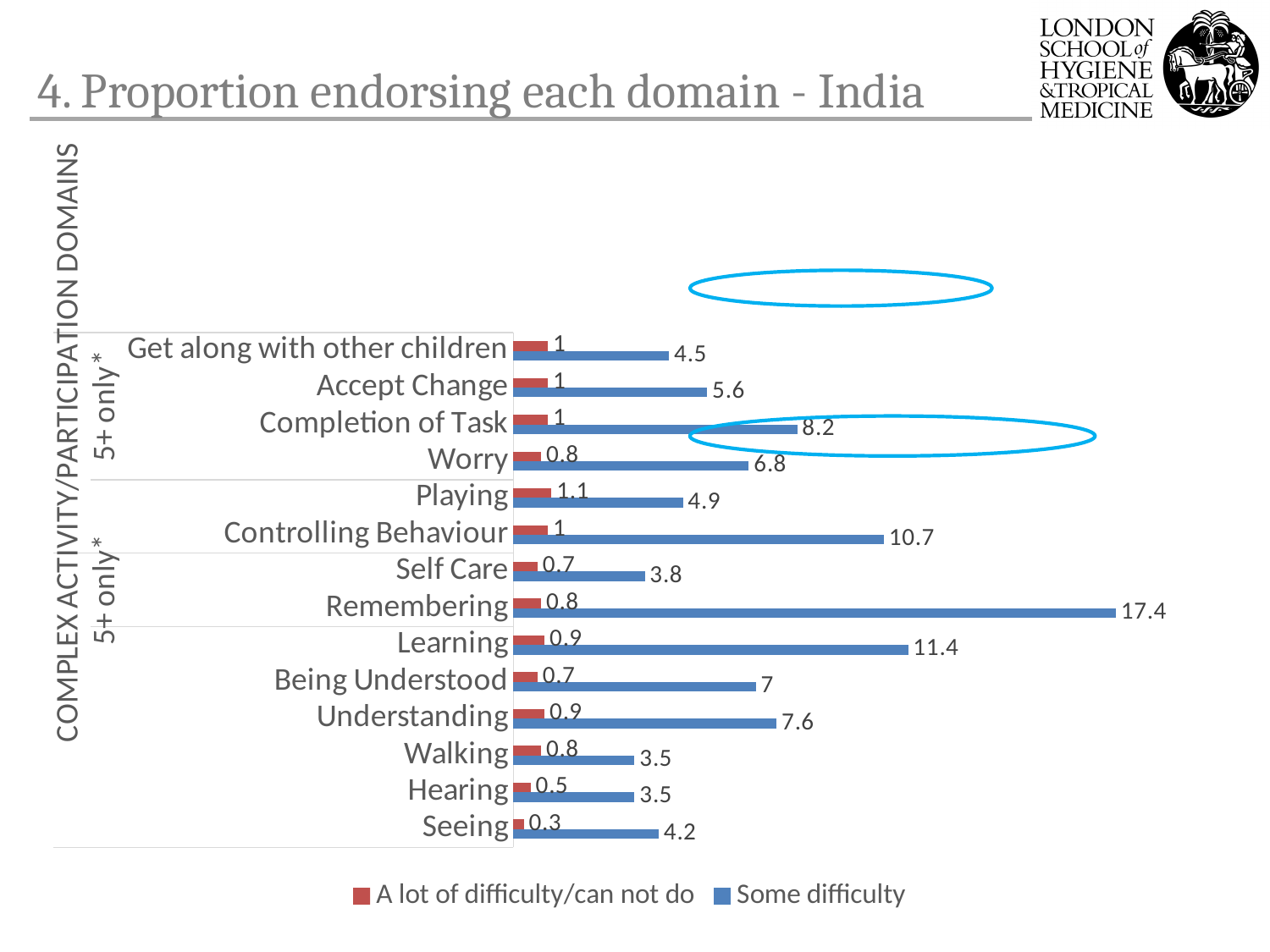
What is the difference between the "Some difficulty" values for Learning and Completion of Task? 3.2 Which domain has the highest value for "Some difficulty"? Remembering What is the value for "Some difficulty" for Remembering? 17.4 How many domains are plotted on the chart? 14 How many series does the legend list? 2 Which is larger: the "Some difficulty" value for Worry or for Accept Change? Worry What kind of chart is shown on the slide? Bar chart Which series is shown in blue in the legend? Some difficulty Which domain has the lowest value for "A lot of difficulty/can not do"? Seeing What is the value for "Some difficulty" for Controlling Behaviour? 10.7 What is the value for "A lot of difficulty/can not do" for Playing? 1.1 What is the value for "A lot of difficulty/can not do" for Seeing? 0.3